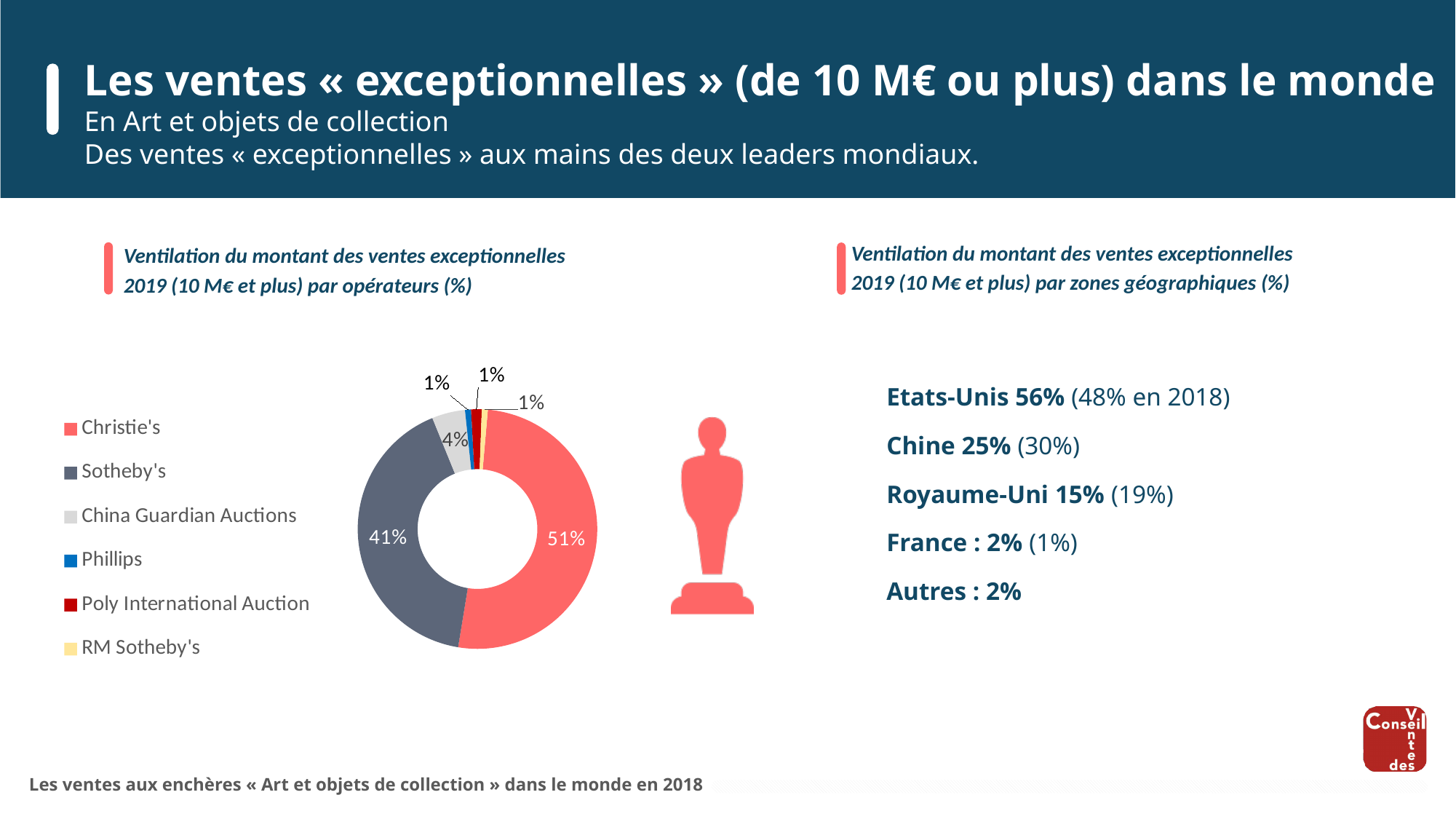
What is the combined share of Christie's and Sotheby's? 92% What share of the exceptional sales amount in 2019 does Sotheby's hold? 41% What share of the exceptional sales amount in 2019 does Christie's hold? 51% What share of the exceptional sales amount in 2019 does Phillips hold? 1% How many operators are listed in the chart legend? 6 Which operator is represented by the yellow slice in the chart? RM Sotheby's Which has a larger share, Sotheby's or China Guardian Auctions? Sotheby's Which operator has the largest share of the exceptional sales amount in 2019? Christie's What share of the exceptional sales amount in 2019 does China Guardian Auctions hold? 4% What is the title of the chart? Ventilation du montant des ventes exceptionnelles 2019 (10 M€ et plus) par opérateurs (%) What is the difference in percentage points between Christie's share and Sotheby's share? 10 percentage points What kind of chart is shown on the slide? Pie chart (donut)